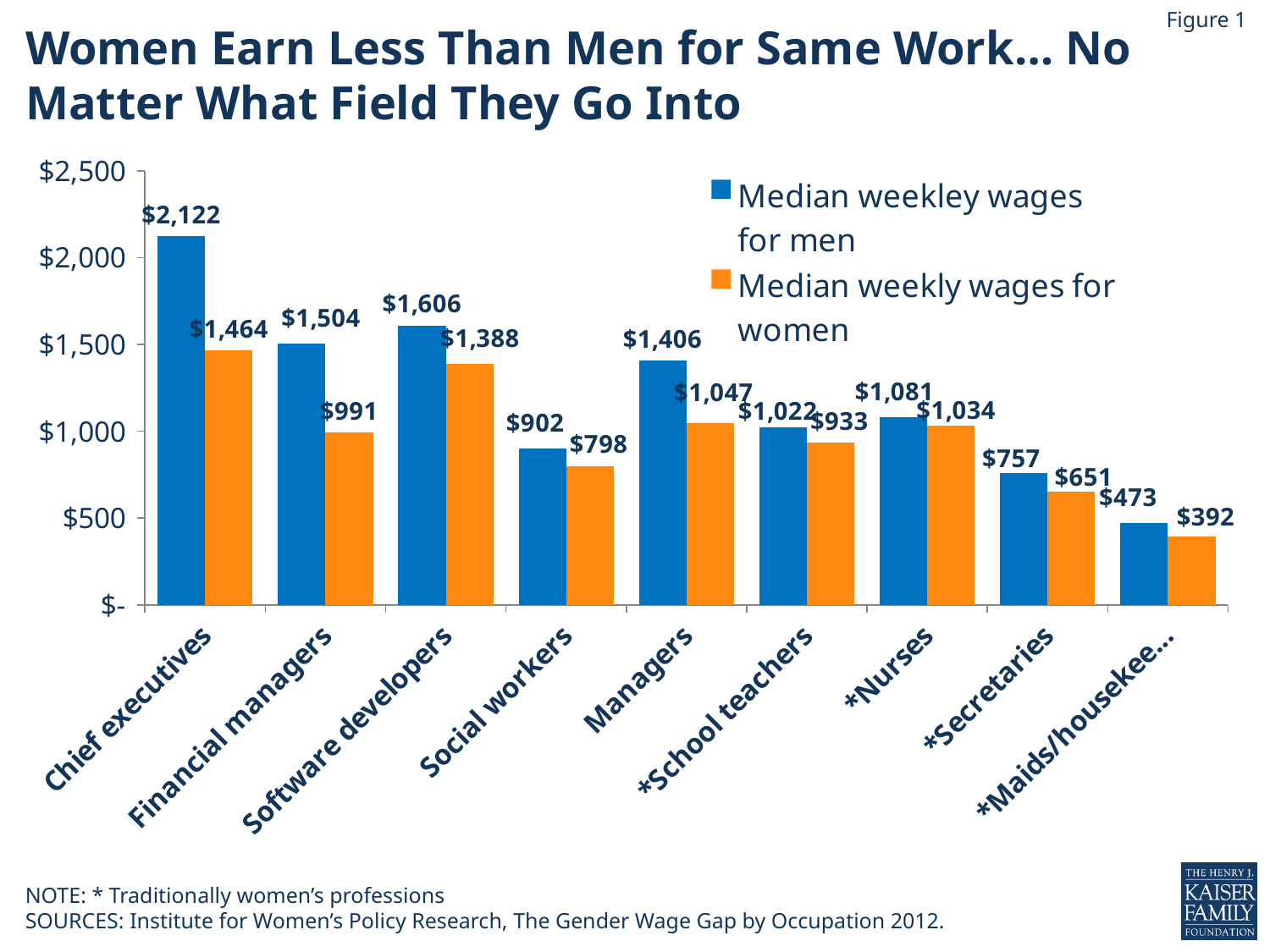
How many series does the legend list? 2 What is the median weekly wage for women among social workers? $798 What is the difference between men's and women's median weekly wages for chief executives? $658 What is the median weekly wage for women among software developers? $1,388 Which occupation has the lowest median weekly wage for women? *Maids/housekeepers What kind of chart is shown on the slide? Bar chart How many occupations are shown on the x axis? 9 What is the median weekly wage for men among chief executives? $2,122 What is the median weekly wage for men among nurses? $1,081 Which occupation has the highest median weekly wage for men? Chief executives What is the difference between men's and women's median weekly wages for software developers? $218 Which is larger: the median weekly wage for men among financial managers or among software developers? Software developers